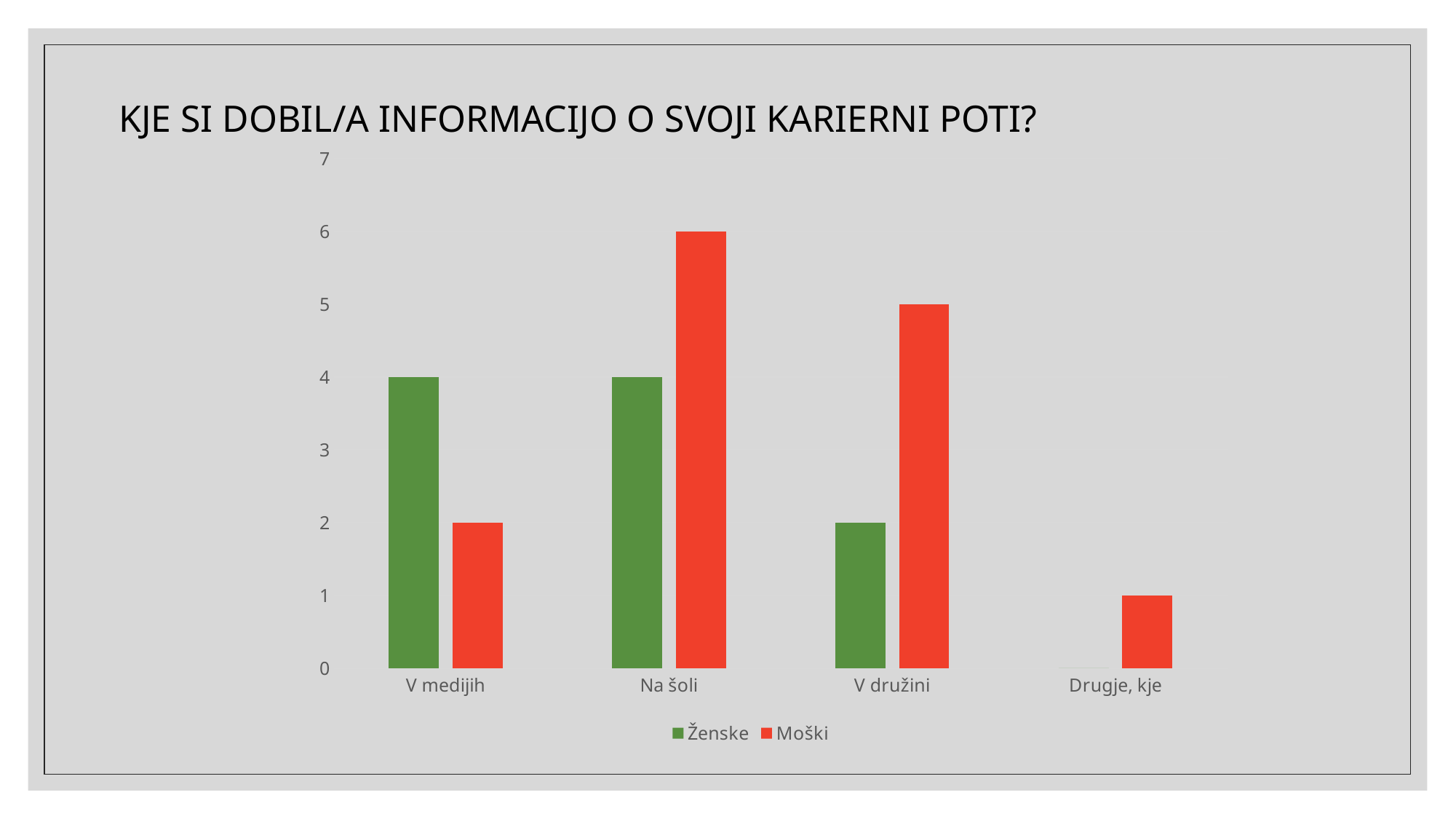
What is the value for Moški in the V družini category? 5 Which colour represents the Moški series in the legend? red How many series does the legend list? 2 What kind of chart is shown on the slide? bar chart In the V medijih category, which series has the larger value, Ženske or Moški? Ženske What is the value for Ženske in the V medijih category? 4 In which category is the Moški value highest? Na šoli How many categories are shown on the x axis? 4 What is the difference between the Moški and Ženske values in the Na šoli category? 2 What is the value for Moški in the Drugje, kje category? 1 What is the value for Moški in the Na šoli category? 6 In which category is the Moški value lowest? Drugje, kje